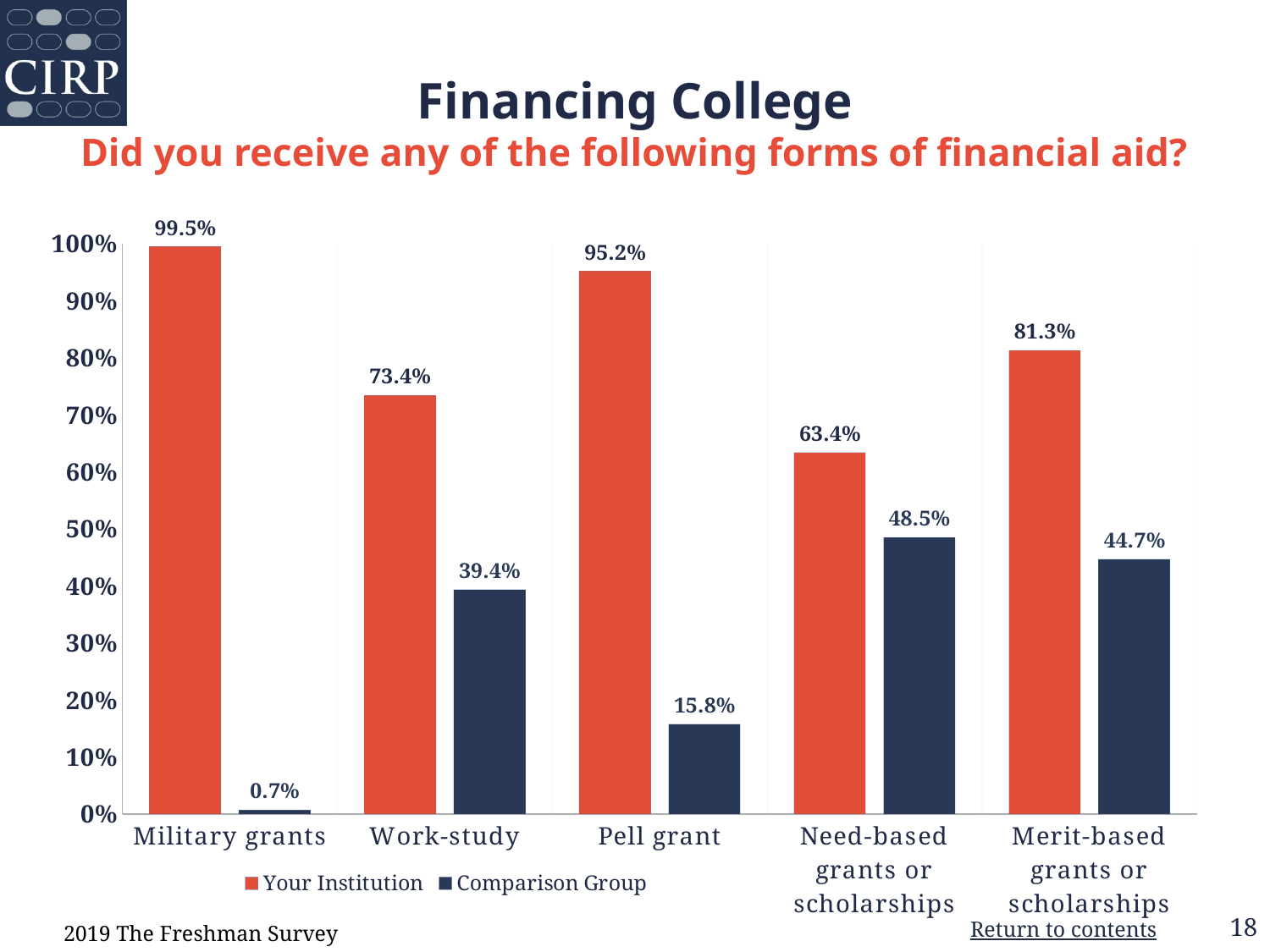
What is the value for Comparison Group for Work-study? 39.4% What kind of chart is shown on the slide? bar chart How many categories are shown on the x axis? 5 What is the value for Your Institution for Pell grant? 95.2% Is the value for Comparison Group for Pell grant greater or less than 20%? less What colour are the bars for Comparison Group? dark navy blue What is the difference between Your Institution and Comparison Group for Need-based grants or scholarships? 14.9% Which is larger for Merit-based grants or scholarships: Your Institution or Comparison Group? Your Institution How many series does the legend list? 2 What is the value for Comparison Group for Military grants? 0.7% Which category has the lowest value for Comparison Group? Military grants Which category has the highest value for Your Institution? Military grants